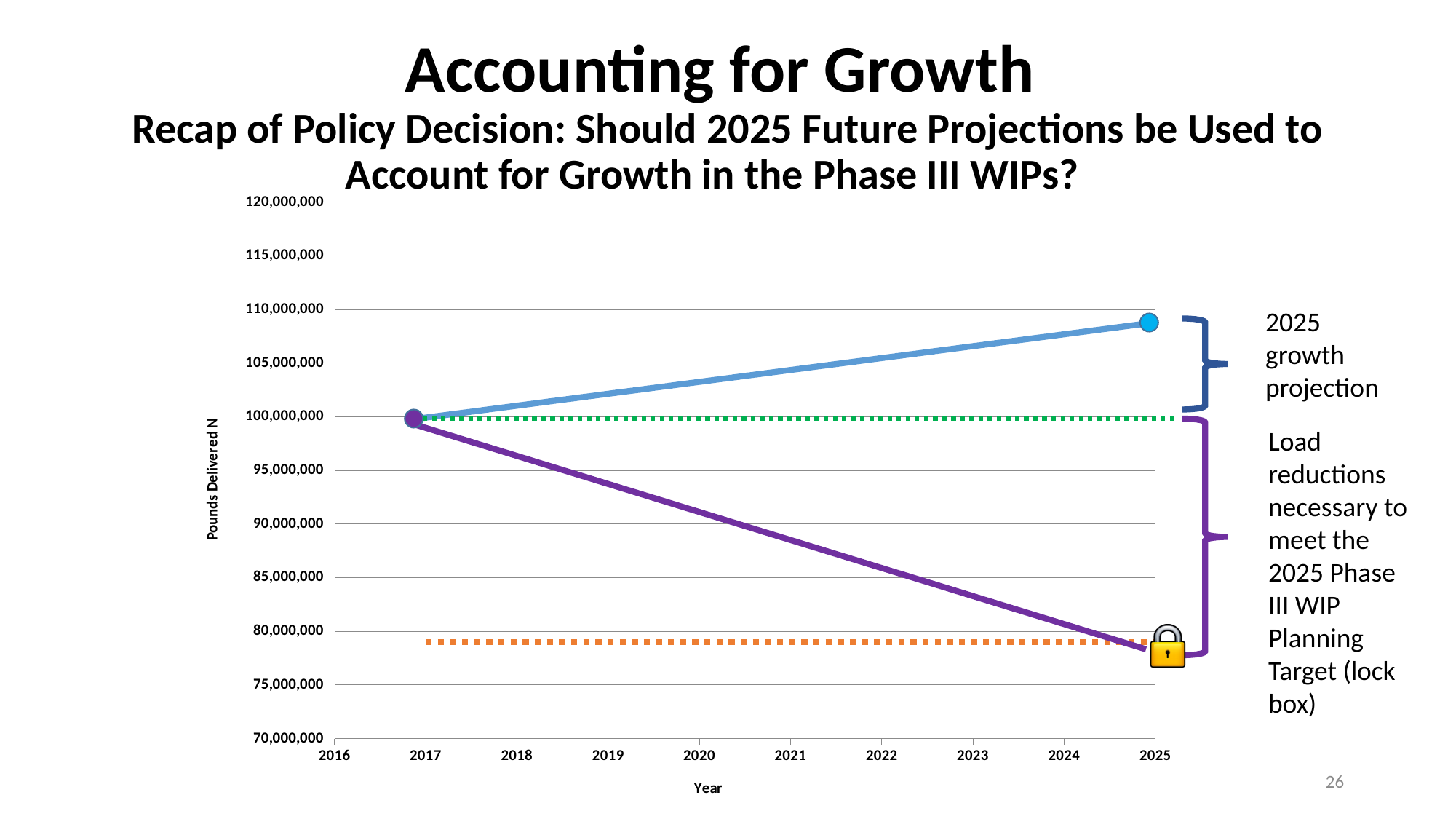
Which line has the higher value in 2025, the blue line or the purple line? the blue line Is the 2025 value of the upper (blue) line greater or less than 110,000,000? less Does the purple line rise or fall from 2017 to 2025? fall Is the 2025 value of the upper (blue) line greater or less than 105,000,000? greater What value do both lines start at in 2017? 100,000,000 What kind of chart is shown on the slide? line chart Is the 2025 value of the lower (purple) line greater or less than 80,000,000? less How many years are labeled on the horizontal axis? 10 What is the title of the horizontal axis? Year Does the blue line rise or fall from 2017 to 2025? rise What is the title of the vertical axis? Pounds Delivered N